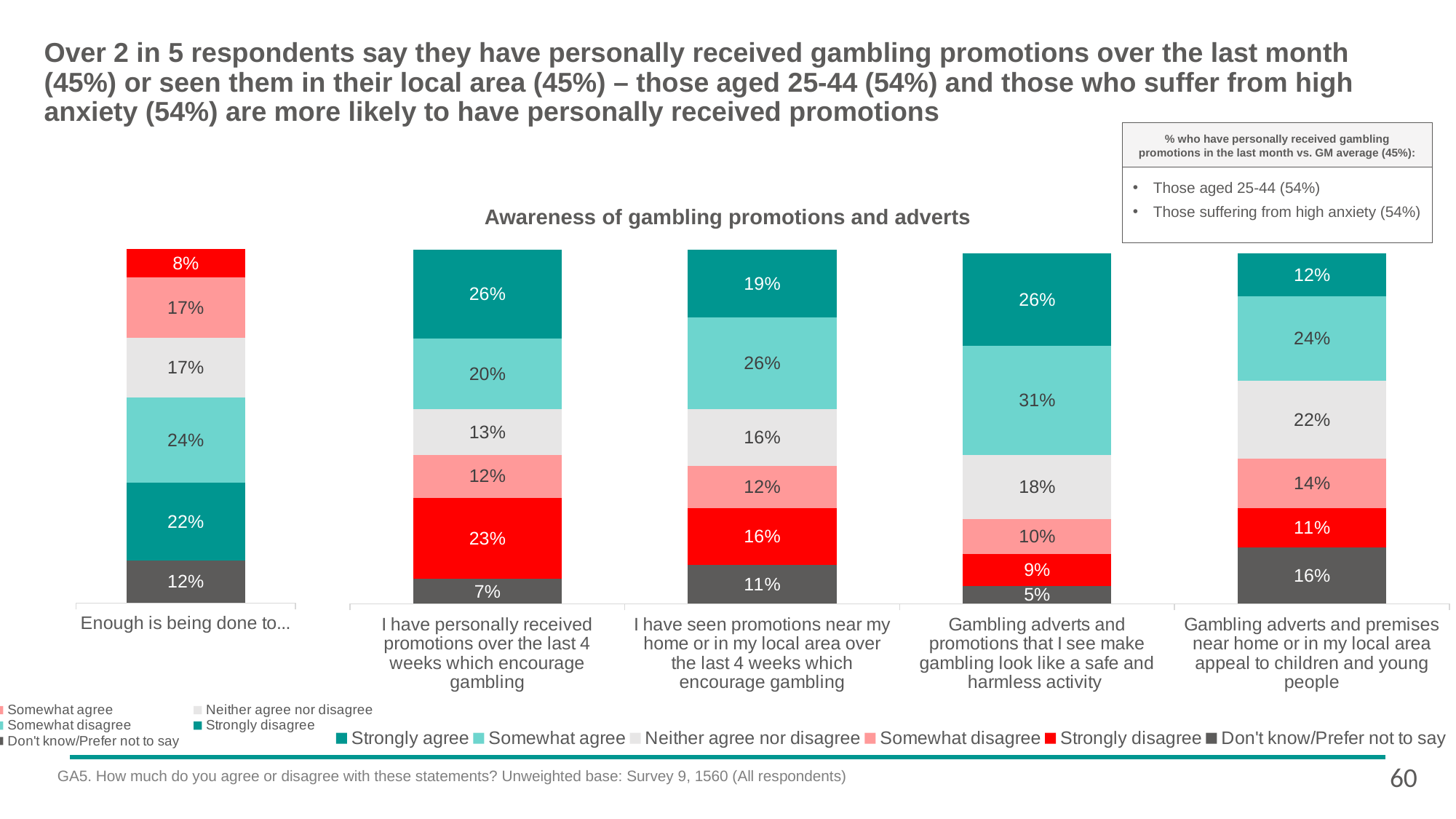
In the 'Awareness of gambling promotions and adverts' chart, which statement has the lowest 'Strongly agree' value? Gambling adverts and premises near home or in my local area appeal to children and young people In the 'Awareness of gambling promotions and adverts' chart, what percentage strongly disagree that they have seen promotions near their home or in their local area over the last 4 weeks? 16% How many statements are shown in the 'Awareness of gambling promotions and adverts' chart? 4 In the 'Awareness of gambling promotions and adverts' chart, what is the 'Don't know/Prefer not to say' value for 'Gambling adverts and premises near home or in my local area appeal to children and young people'? 16% In the 'Awareness of gambling promotions and adverts' chart, which is larger: the 'Neither agree nor disagree' value for 'Gambling adverts and premises near home appeal to children and young people' or for 'I have personally received promotions over the last 4 weeks'? Gambling adverts and premises near home or in my local area appeal to children and young people In the 'Awareness of gambling promotions and adverts' chart, which statement has the highest 'Strongly disagree' value? I have personally received promotions over the last 4 weeks which encourage gambling In the small chart on the left titled 'Enough is being done to...', what is the 'Somewhat disagree' value? 24% What kind of chart is the 'Awareness of gambling promotions and adverts' chart? Stacked bar chart How many series does the legend of the 'Awareness of gambling promotions and adverts' chart list? 6 In the 'Awareness of gambling promotions and adverts' chart, what is the difference between the 'Strongly agree' values for 'I have personally received promotions over the last 4 weeks' and 'I have seen promotions near my home or in my local area'? 7% In the 'Awareness of gambling promotions and adverts' chart, what percentage strongly agree that they have personally received promotions over the last 4 weeks which encourage gambling? 26% In the 'Awareness of gambling promotions and adverts' chart, what percentage somewhat agree that gambling adverts and promotions they see make gambling look like a safe and harmless activity? 31%